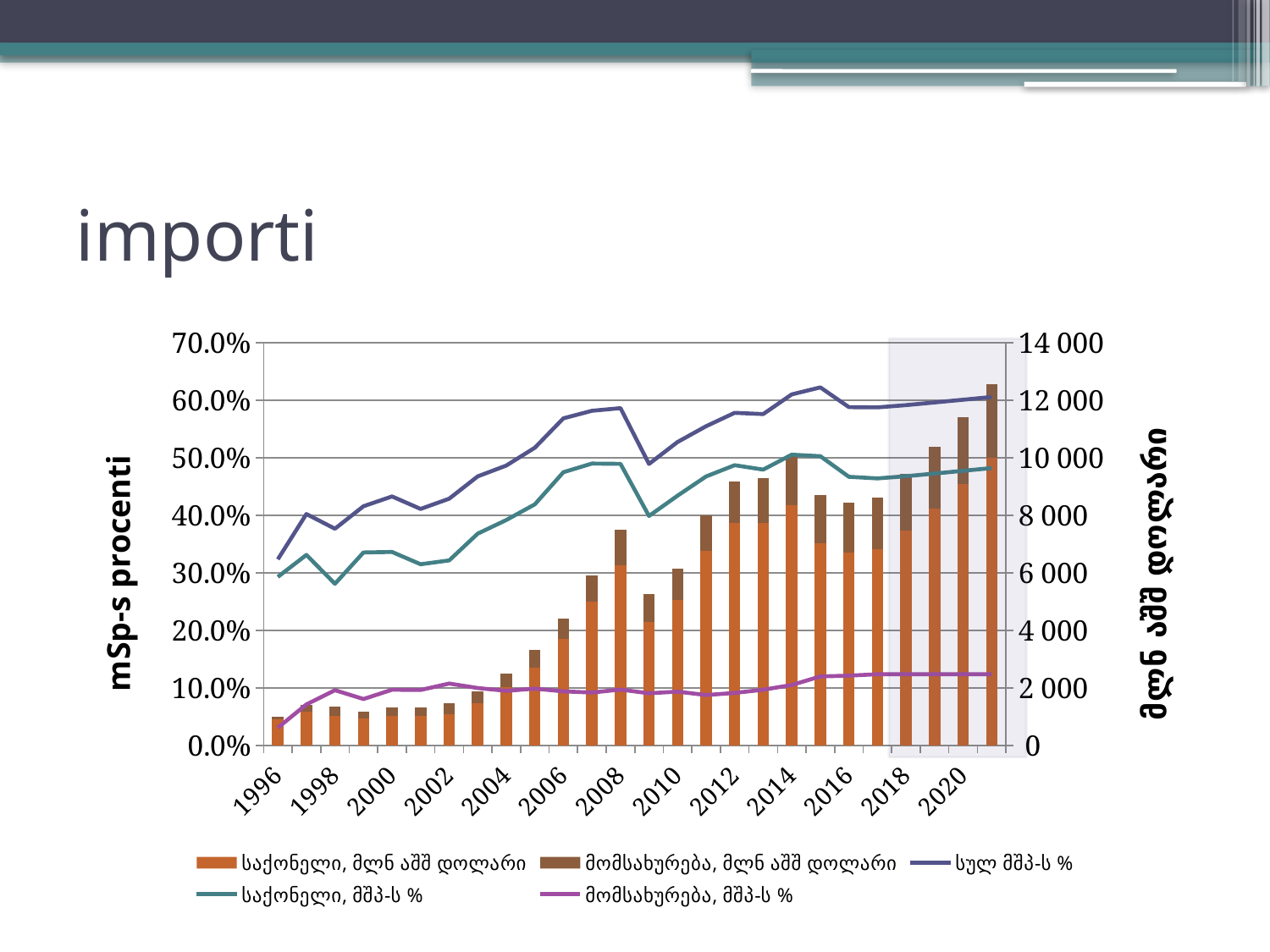
Is the total height of the stacked bar for 2021 greater or less than 10 000 on the right axis? greater Which is higher for the 'სულ მშპ-ს %' line: the value in 2009 or the value in 2015? 2015 Is the value of the 'მომსახურება, მშპ-ს %' line in 2020 greater or less than 10.0%? greater Is the value of the 'სულ მშპ-ს %' line in 2008 greater or less than 50.0%? greater What kind of chart is shown on the slide? A combined bar and line chart (stacked bars with lines) Which year has the tallest stacked bar? 2021 Which year has the shortest stacked bar? 1996 Do the stacked bars generally rise or fall from 1996 to 2021? Rise What is the title of the left vertical axis? mSp-s procenti How many series does the chart legend list? 5